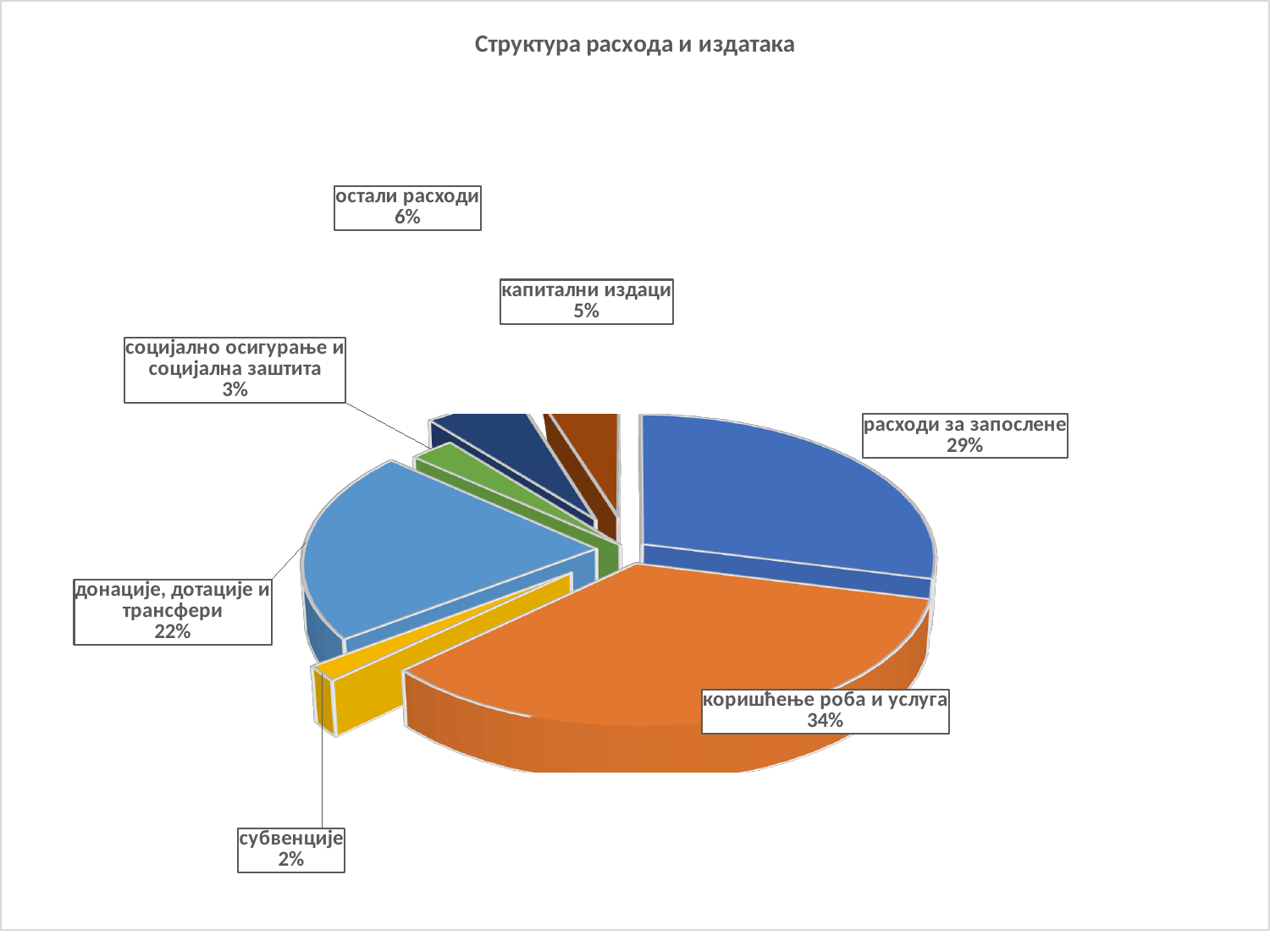
What is the share for капитални издаци? 5% How many categories are shown in the pie chart? 7 Which category has the largest share of the pie? коришћење роба и услуга What is the share for коришћење роба и услуга? 34% What is the difference in percentage points between коришћење роба и услуга and расходи за запослене? 5 Which category has the smallest share of the pie? субвенције Which is larger, the share for остали расходи or the share for капитални издаци? остали расходи What is the share for донације, дотације и трансфери? 22% What kind of chart is shown on the slide? pie chart What is the share for расходи за запослене? 29% What is the share for субвенције? 2% What is the title of the chart? Структура расхода и издатака